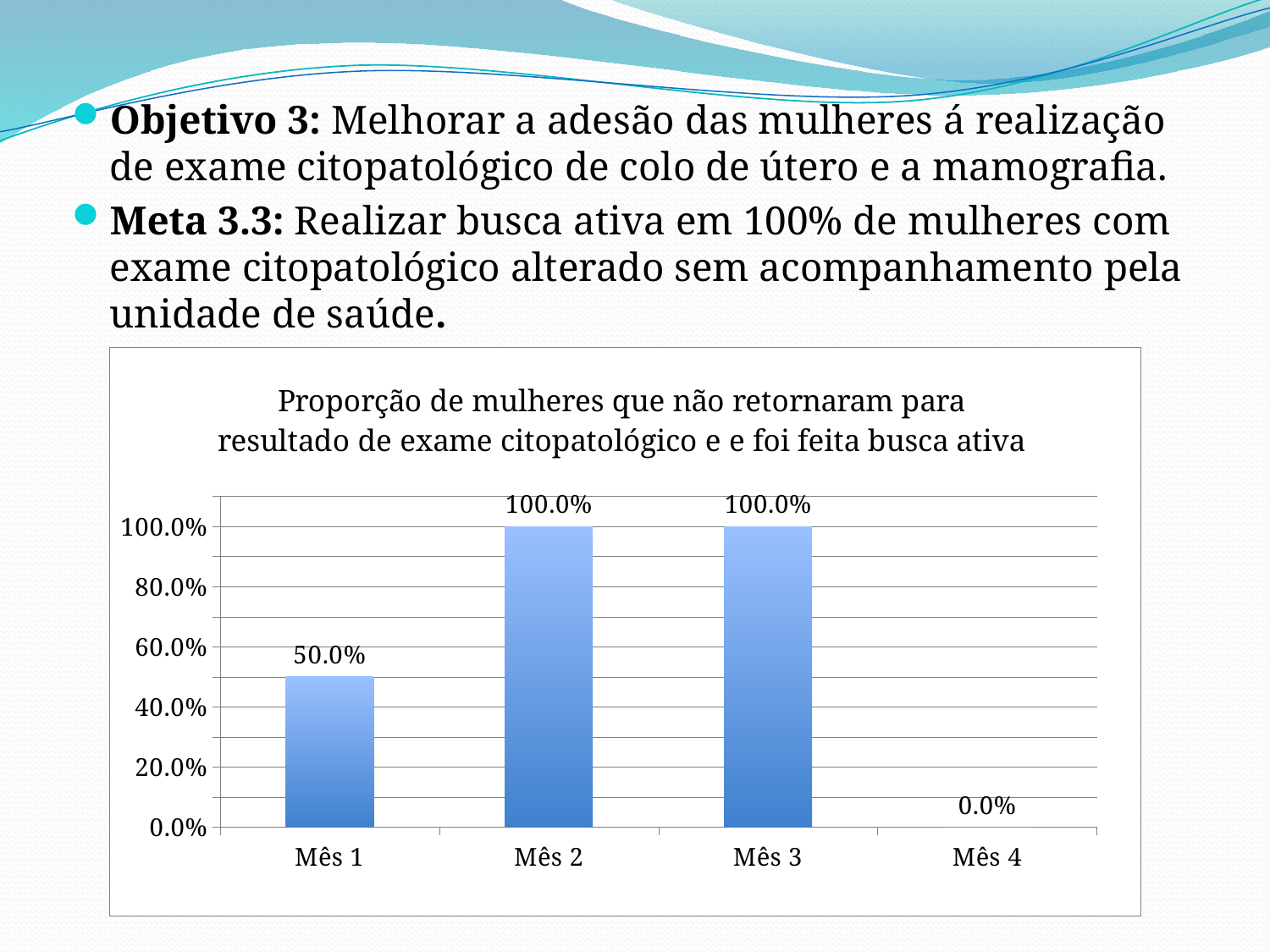
What is the title of the chart? Proporção de mulheres que não retornaram para resultado de exame citopatológico e e foi feita busca ativa What is the difference between the values for Mês 2 and Mês 1? 50.0% Which month has the lowest value? Mês 4 What is the value for Mês 2? 100.0% Does the value rise or fall from Mês 3 to Mês 4? fall What kind of chart is shown on the slide? bar chart What is the highest value shown on the y axis? 100.0% Is the value for Mês 1 greater or less than 40.0%? greater Which is larger, the value for Mês 1 or the value for Mês 3? Mês 3 What is the value for Mês 1? 50.0% What is the value for Mês 4? 0.0% How many months are shown on the x axis? 4